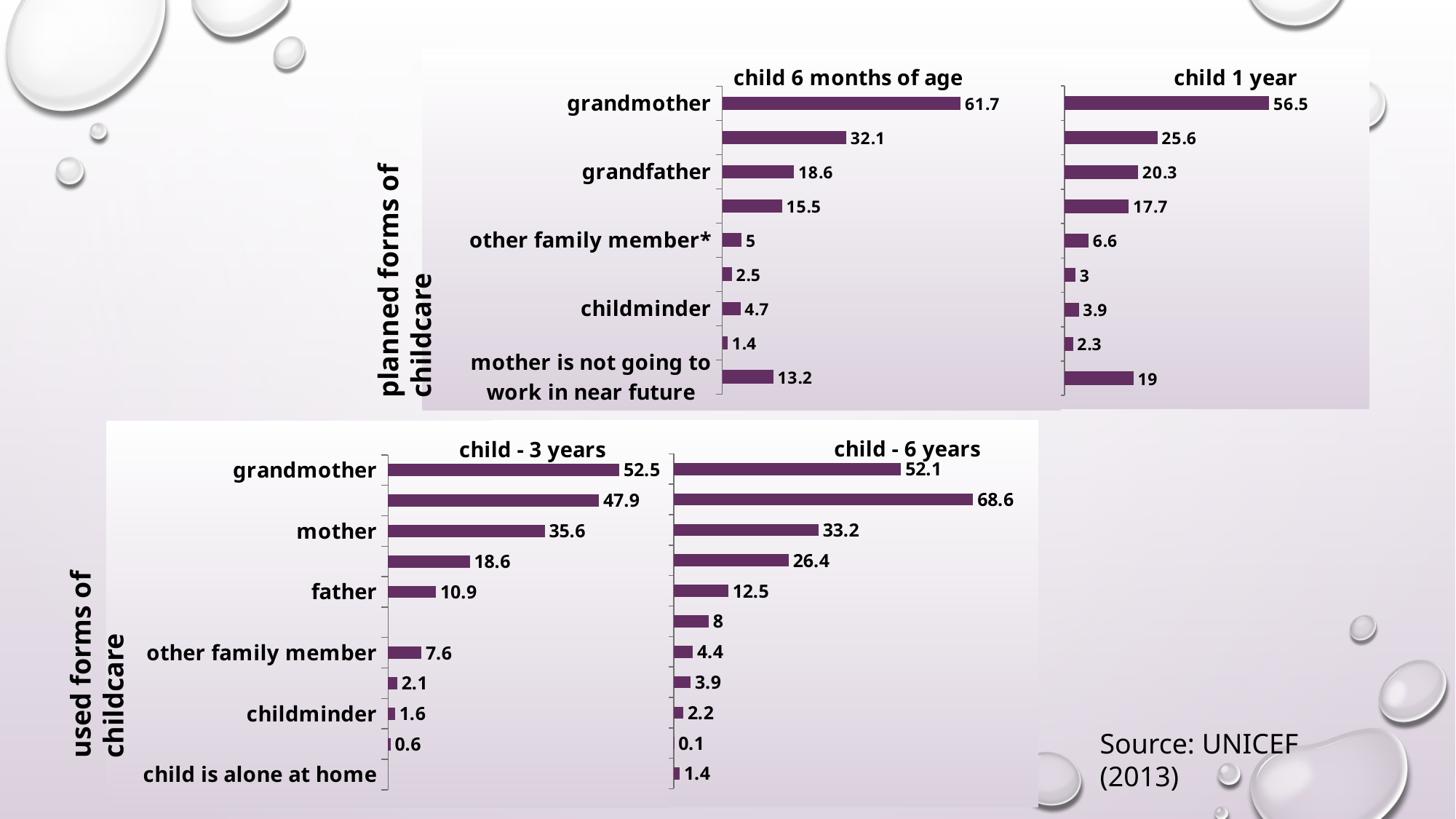
What type of chart is used on this slide? bar chart In the 'child - 3 years' chart, what is the difference between the values for mother and father? 24.7 In the 'child 1 year' chart (planned forms of childcare), what is the value for 'mother is not going to work in near future'? 19 What source is cited for the data on the slide? UNICEF (2013) In the 'child 6 months of age' chart (planned forms of childcare), what is the value for grandmother? 61.7 In the 'child - 3 years' chart (used forms of childcare), what is the value for mother? 35.6 In the 'child - 6 years' chart (used forms of childcare), what is the value for father? 12.5 In the 'child - 6 years' chart, is the value for other family member larger or smaller than the value for childminder? larger In the 'child 6 months of age' chart, which labelled category has the highest value? grandmother Is the grandfather value larger in the 'child 6 months of age' chart or the 'child 1 year' chart? child 1 year What is the difference between the grandmother values in the 'child 6 months of age' chart and the 'child 1 year' chart? 5.2 In the 'child - 6 years' chart, which labelled category has the lowest value? child is alone at home